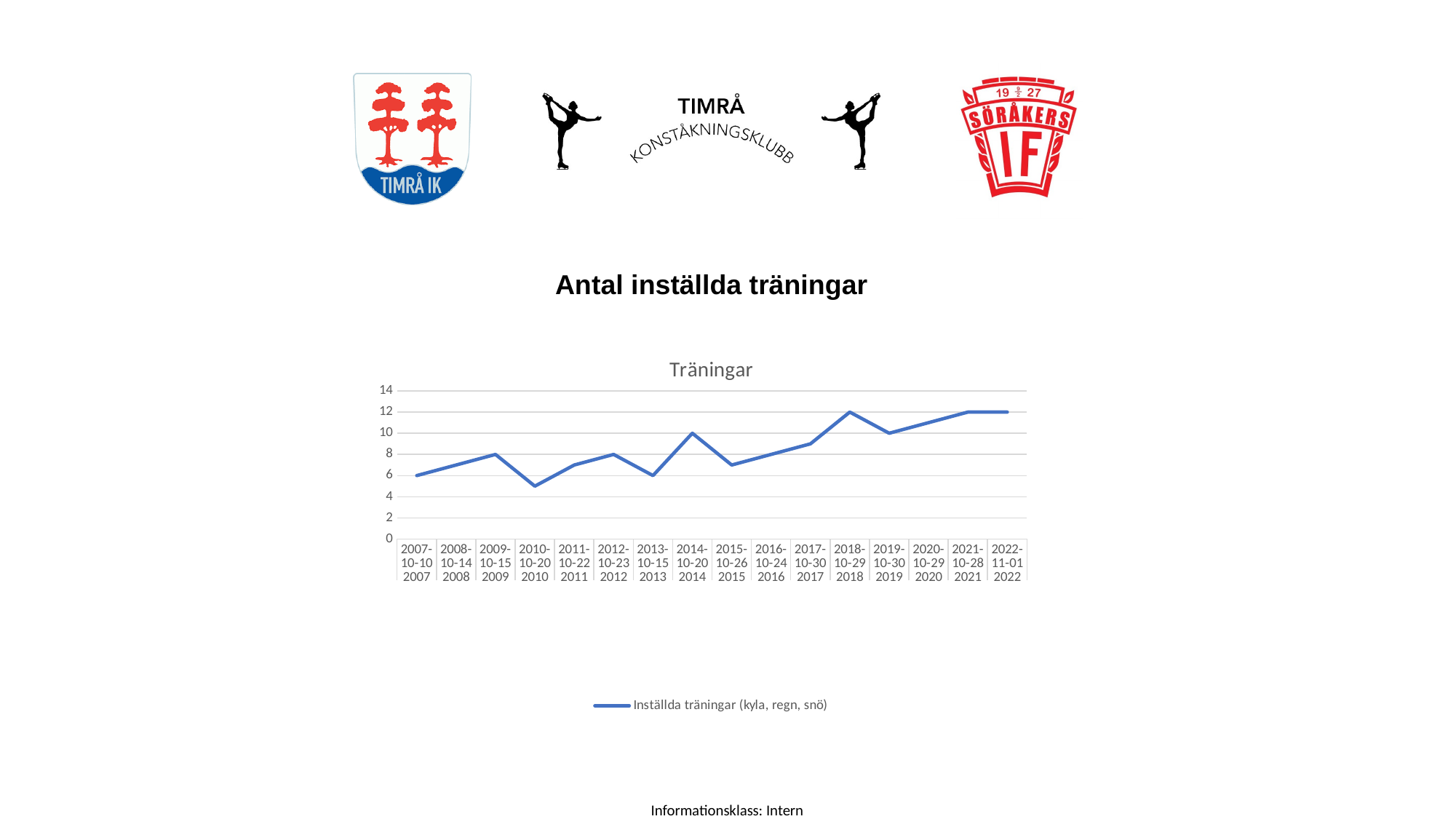
What is the value for 2014-10-20 2014? 10 What is the legend entry for the plotted series? Inställda träningar (kyla, regn, snö) What is the title of the chart? Träningar Is the value for 2010-10-20 2010 greater or less than 6? less Is the value for 2017-10-30 2017 greater or less than 8? greater What is the value for 2018-10-29 2018? 12 What kind of chart is shown on the slide? line chart Which date has the lowest value? 2010-10-20 2010 How many data points are plotted on the chart? 16 How many series does the legend list? 1 What is the value for 2007-10-10 2007? 6 Which is larger, the value for 2013-10-15 2013 or the value for 2014-10-20 2014? 2014-10-20 2014